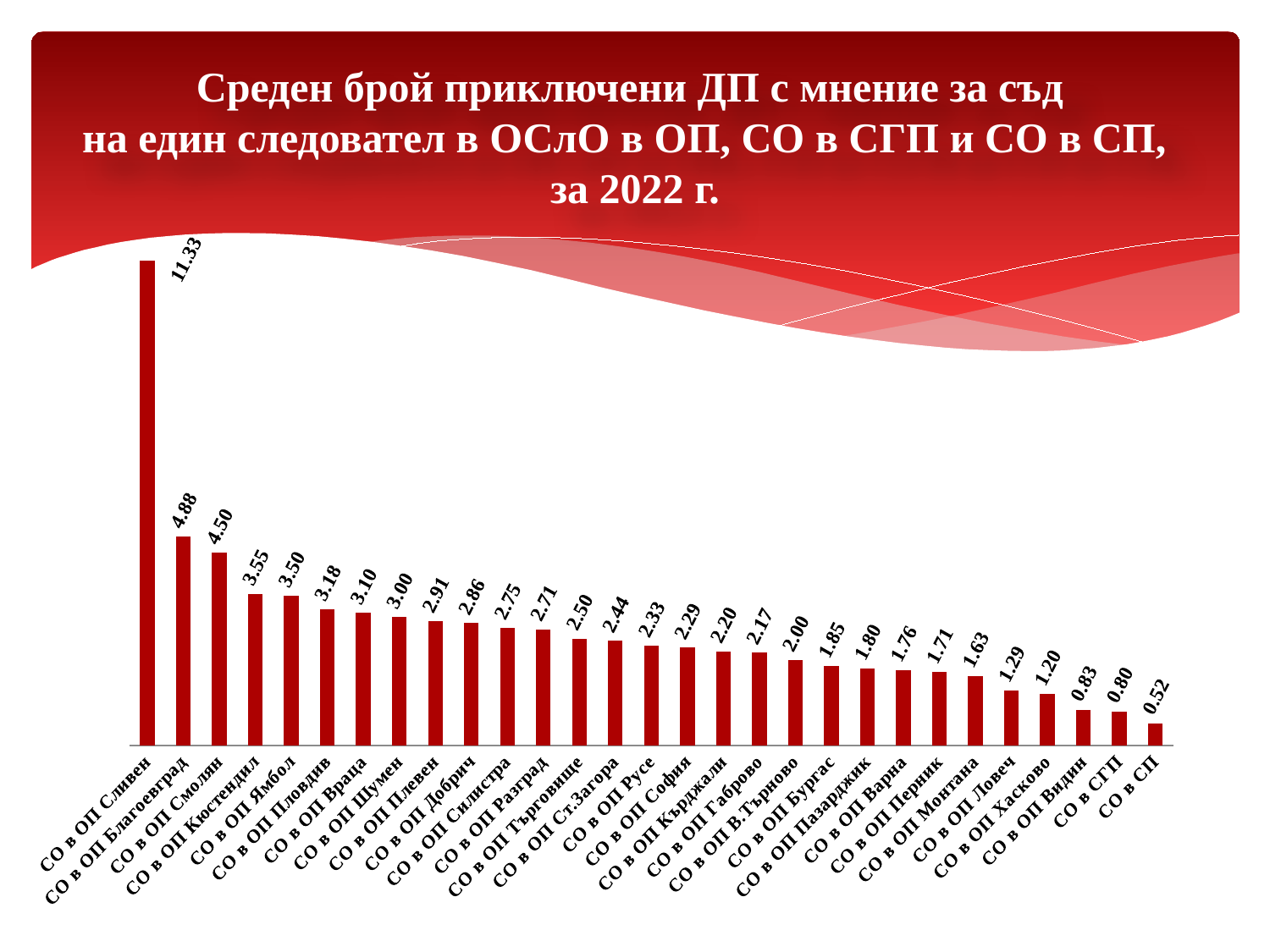
Which category has the lowest value? СО в СП Do the values rise or fall from left to right along the x axis? Fall What is the value for СО в ОП Варна? 1.76 Which is larger, the value for СО в ОП Пловдив or the value for СО в ОП Бургас? СО в ОП Пловдив What is the difference between the values for СО в ОП Благоевград and СО в ОП Смолян? 0.38 What is the value for СО в ОП Сливен? 11.33 What is the value for СО в СГП? 0.80 Which category has the highest value? СО в ОП Сливен How many categories are shown in the chart? 29 What kind of chart is shown on the slide? Bar chart What is the difference between the values for СО в ОП Сливен and СО в СП? 10.81 What year does the chart title say the data is for? 2022